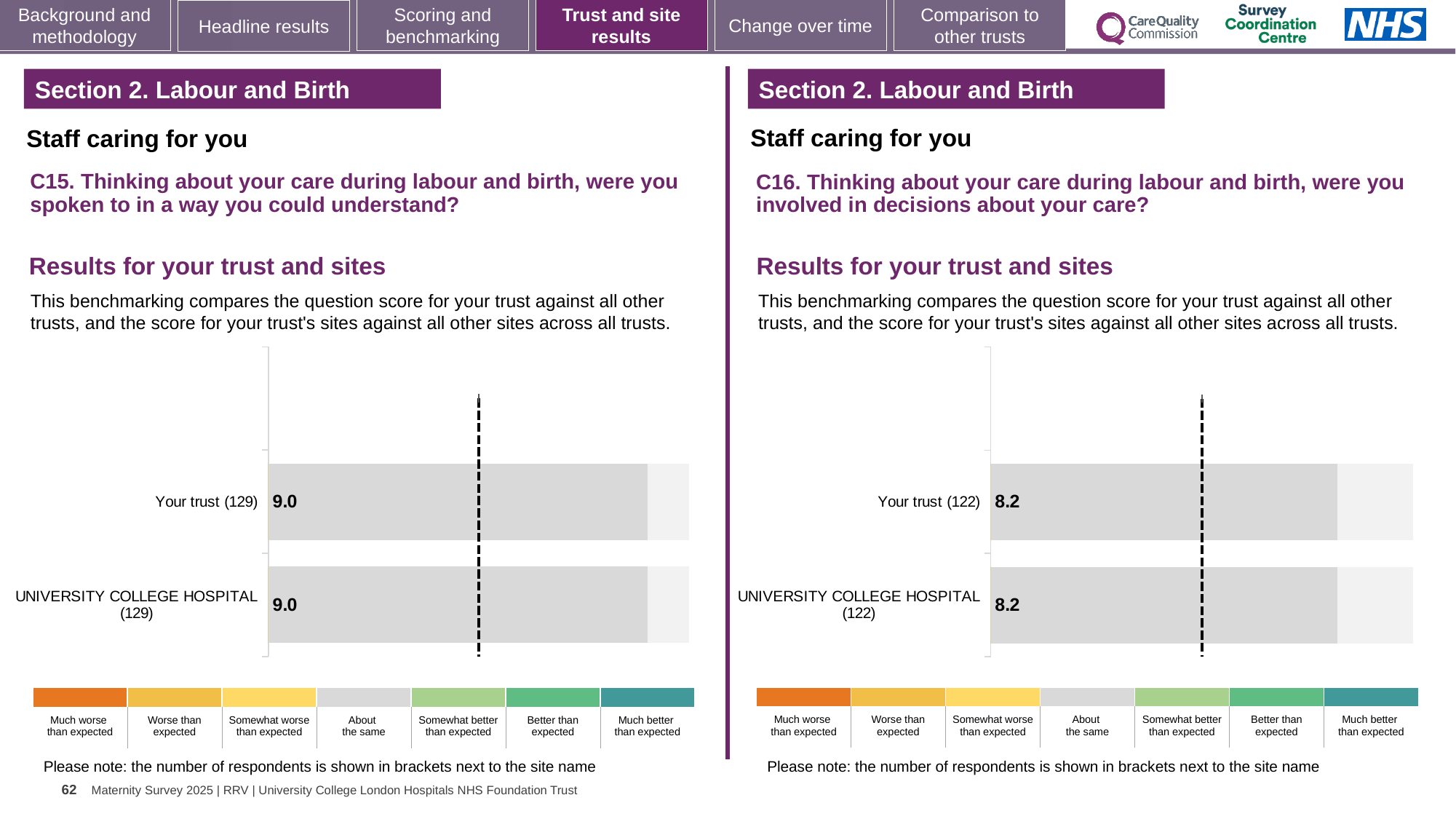
In the C15 chart on the left, what is the score for Your trust? 9.0 How many bars are plotted in the C16 chart on the right? 2 In the C16 chart on the right, what is the score for Your trust? 8.2 How many bars are plotted in the C15 chart on the left? 2 In the C15 chart on the left, what is the difference between the score for Your trust and the score for UNIVERSITY COLLEGE HOSPITAL? 0.0 In the C16 chart on the right, how many respondents are shown in brackets for UNIVERSITY COLLEGE HOSPITAL? 122 How many benchmark categories does the colour key below the C16 chart on the right list? 7 In the C15 chart on the left, how many respondents are shown in brackets for Your trust? 129 In the colour key below the C15 chart on the left, which category is shown in grey? About the same What kind of chart is used for the C15 results on the left? Bar chart In the C16 chart on the right, what is the score for UNIVERSITY COLLEGE HOSPITAL? 8.2 In the C15 chart on the left, what is the score for UNIVERSITY COLLEGE HOSPITAL? 9.0